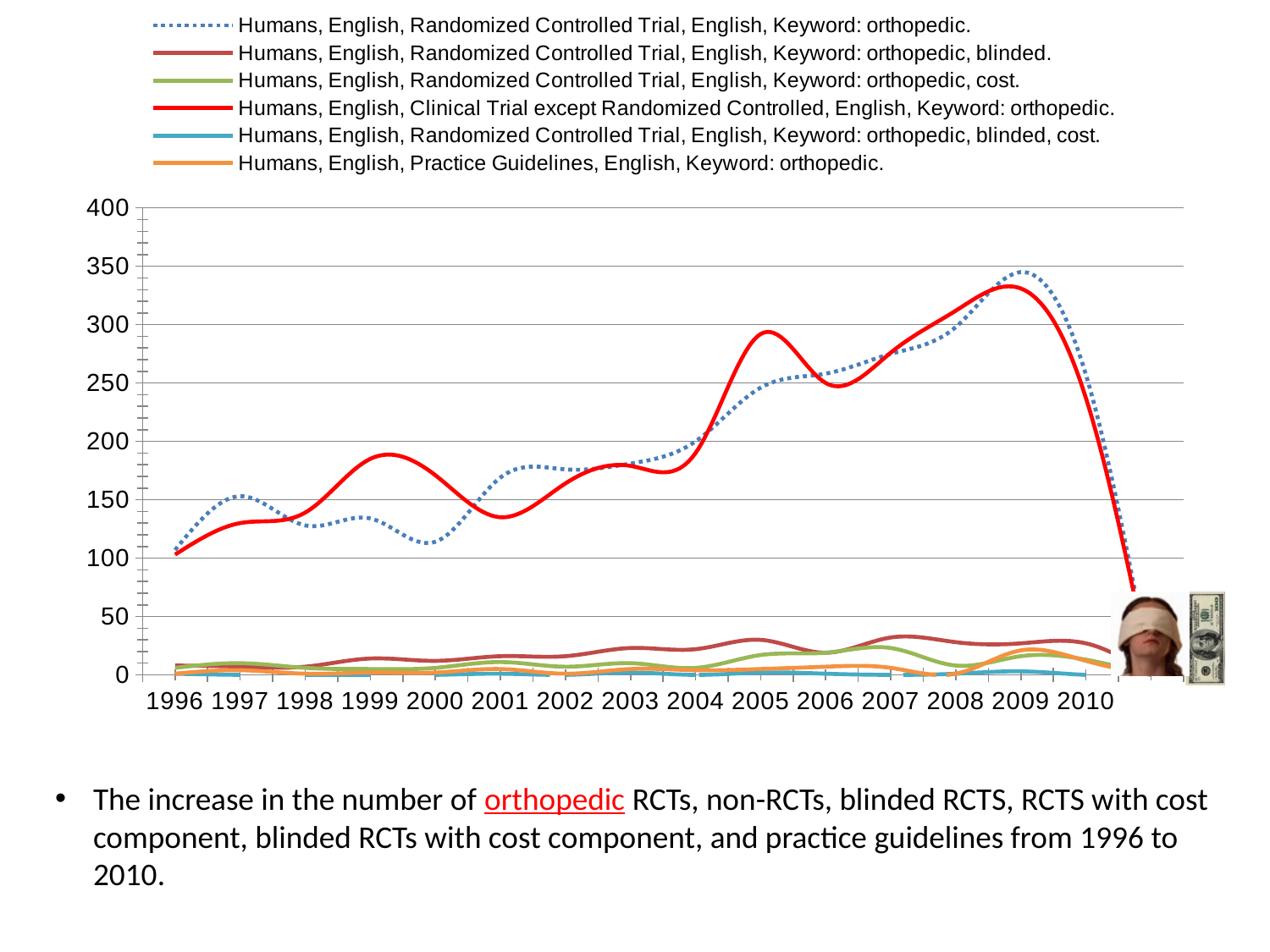
In 1999, which is higher: the solid red 'Clinical Trial except Randomized Controlled' series or the dotted blue 'Randomized Controlled Trial, Keyword: orthopedic' series? The solid red Clinical Trial except Randomized Controlled series In which year does the dotted blue 'Randomized Controlled Trial, Keyword: orthopedic' series reach its highest value? 2009 How many years are shown along the x axis? 15 In 2005, which is higher: the solid red 'Clinical Trial except Randomized Controlled' series or the dotted blue 'Randomized Controlled Trial, Keyword: orthopedic' series? The solid red Clinical Trial except Randomized Controlled series What kind of chart is shown on the slide? Line chart Is the value of the solid red 'Clinical Trial except Randomized Controlled' series in 2001 greater or less than 150? less Is the value of the solid red 'Clinical Trial except Randomized Controlled' series in 2005 greater or less than 250? greater Which series is drawn with a dotted line? Humans, English, Randomized Controlled Trial, English, Keyword: orthopedic. Does the dotted blue 'Randomized Controlled Trial, Keyword: orthopedic' series rise or fall from 2004 to 2009? Rise Is the value of the dotted blue 'Randomized Controlled Trial, Keyword: orthopedic' series in 2000 greater or less than 150? less How many series does the legend list? 6